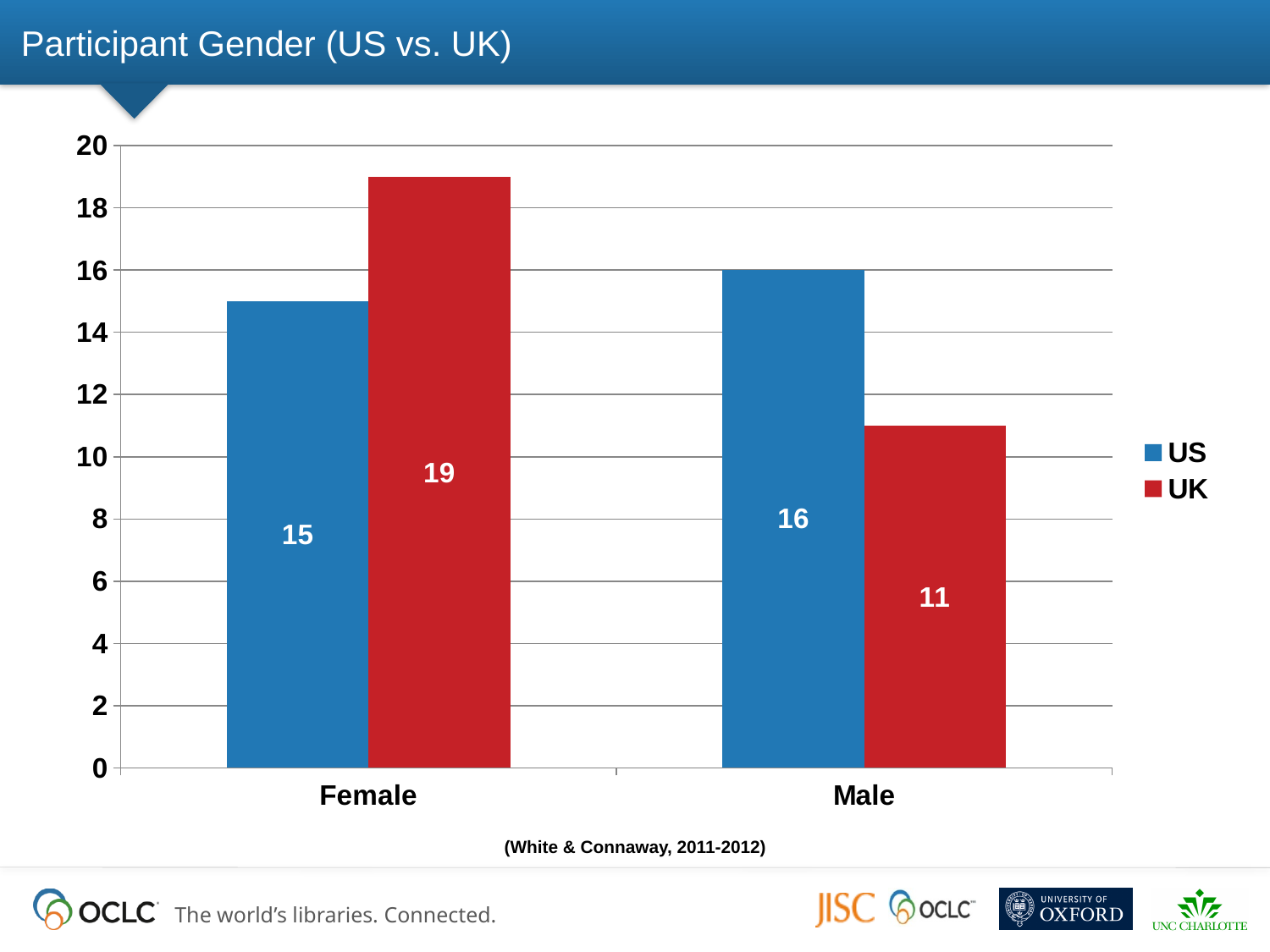
What is the difference between the US Male and US Female values? 1 What is the value for US Female participants? 15 What is the value for UK Female participants? 19 Which bar has the highest value on the chart? UK Female What is the difference between the UK Female and UK Male values? 8 What is the value for US Male participants? 16 What kind of chart is shown on the slide? Bar chart How many categories are shown on the x axis? 2 What is the value for UK Male participants? 11 How many series does the legend list? 2 Which bar has the lowest value on the chart? UK Male Which is larger, the UK Female value or the US Female value? UK Female